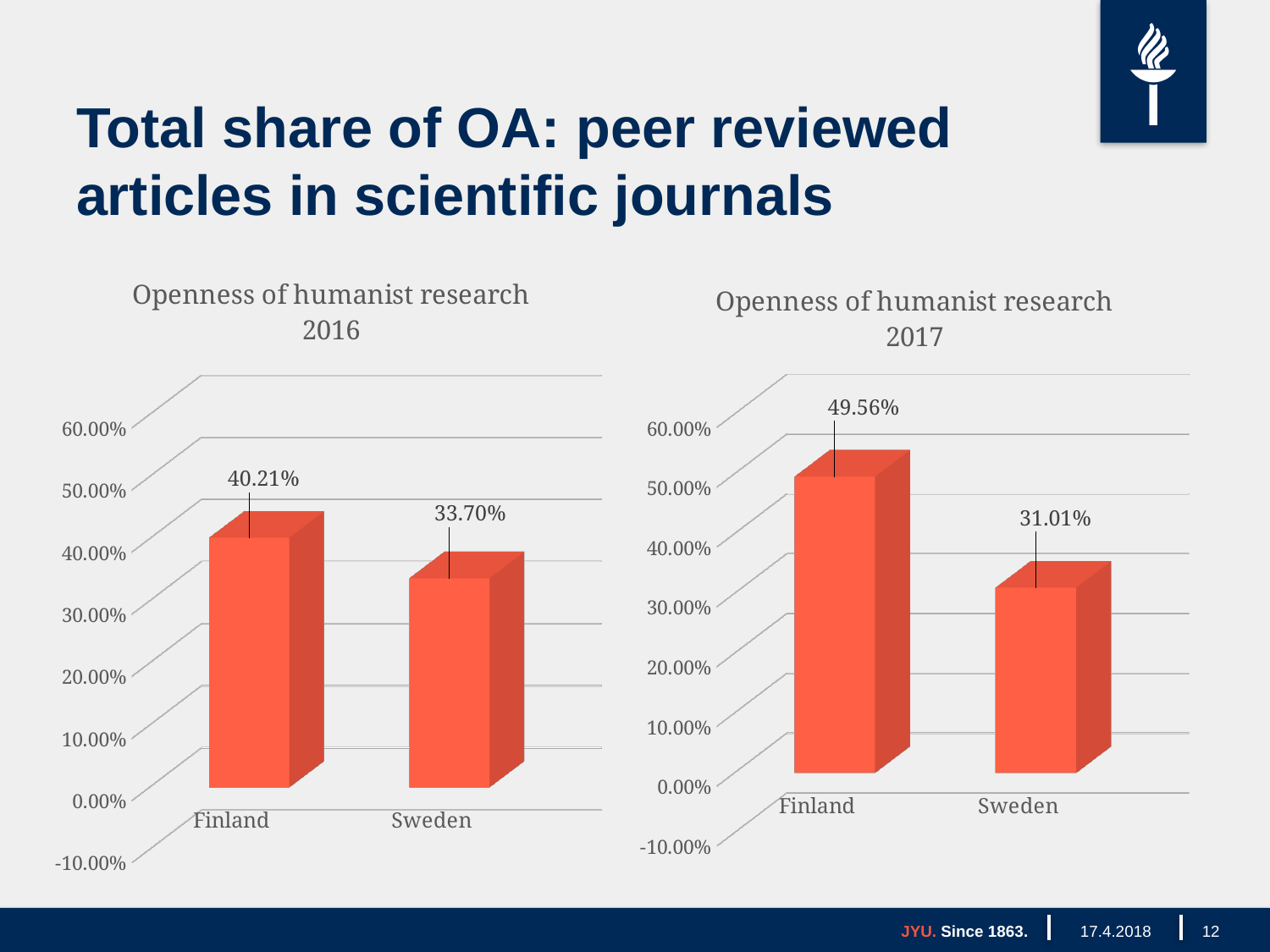
In the 'Openness of humanist research 2016' chart, what is the value for Finland? 40.21% In the 'Openness of humanist research 2017' chart, which country has the highest value? Finland In the 'Openness of humanist research 2017' chart, what is the value for Sweden? 31.01% In the 'Openness of humanist research 2017' chart, what is the difference between the values for Finland and Sweden? 18.55% How many categories are shown in the 'Openness of humanist research 2016' chart? 2 What is the title of the chart on the left side of the slide? Openness of humanist research 2016 In the 'Openness of humanist research 2016' chart, which country has the lowest value? Sweden In the 'Openness of humanist research 2017' chart, what is the value for Finland? 49.56% In the 'Openness of humanist research 2016' chart, what is the difference between the values for Finland and Sweden? 6.51% In the 'Openness of humanist research 2016' chart, what is the value for Sweden? 33.70% In the 'Openness of humanist research 2017' chart, is the value for Finland greater or less than 40.00%? greater What kind of chart is the 'Openness of humanist research 2017' chart? Bar chart